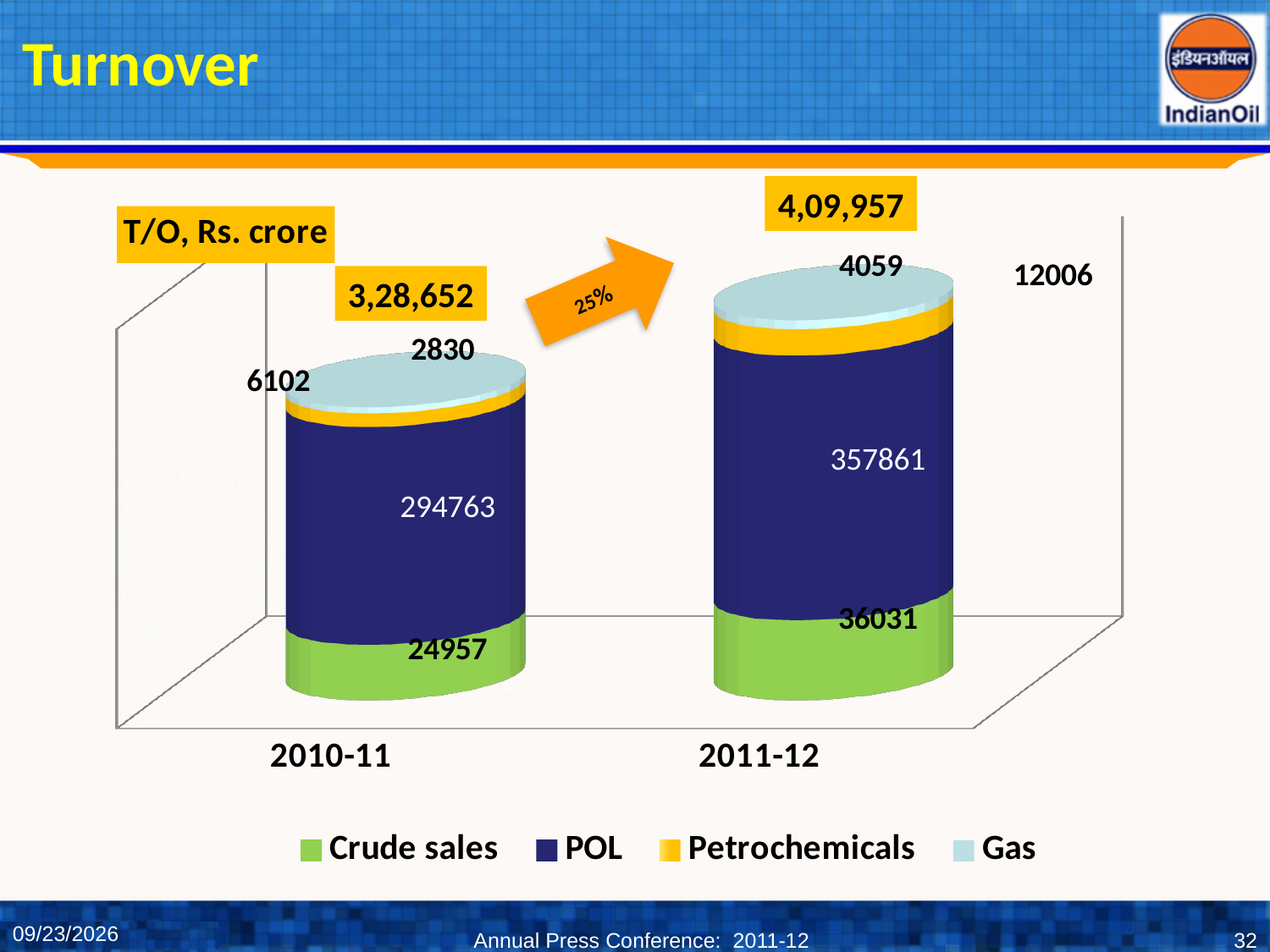
What type of chart is shown on the slide? stacked bar chart What percentage growth is shown on the arrow between the two bars? 25% Which year has the larger Crude sales value, 2010-11 or 2011-12? 2011-12 How many categories (years) are shown on the x axis? 2 What is the Crude sales value for 2010-11? 24957 What is the total turnover shown for 2011-12? 4,09,957 What is the POL value for 2010-11? 294763 What is the Crude sales value for 2011-12? 36031 What is the total turnover shown for 2010-11? 3,28,652 How many series does the legend list? 4 What is the POL value for 2011-12? 357861 What is the difference in POL between 2011-12 and 2010-11? 63098